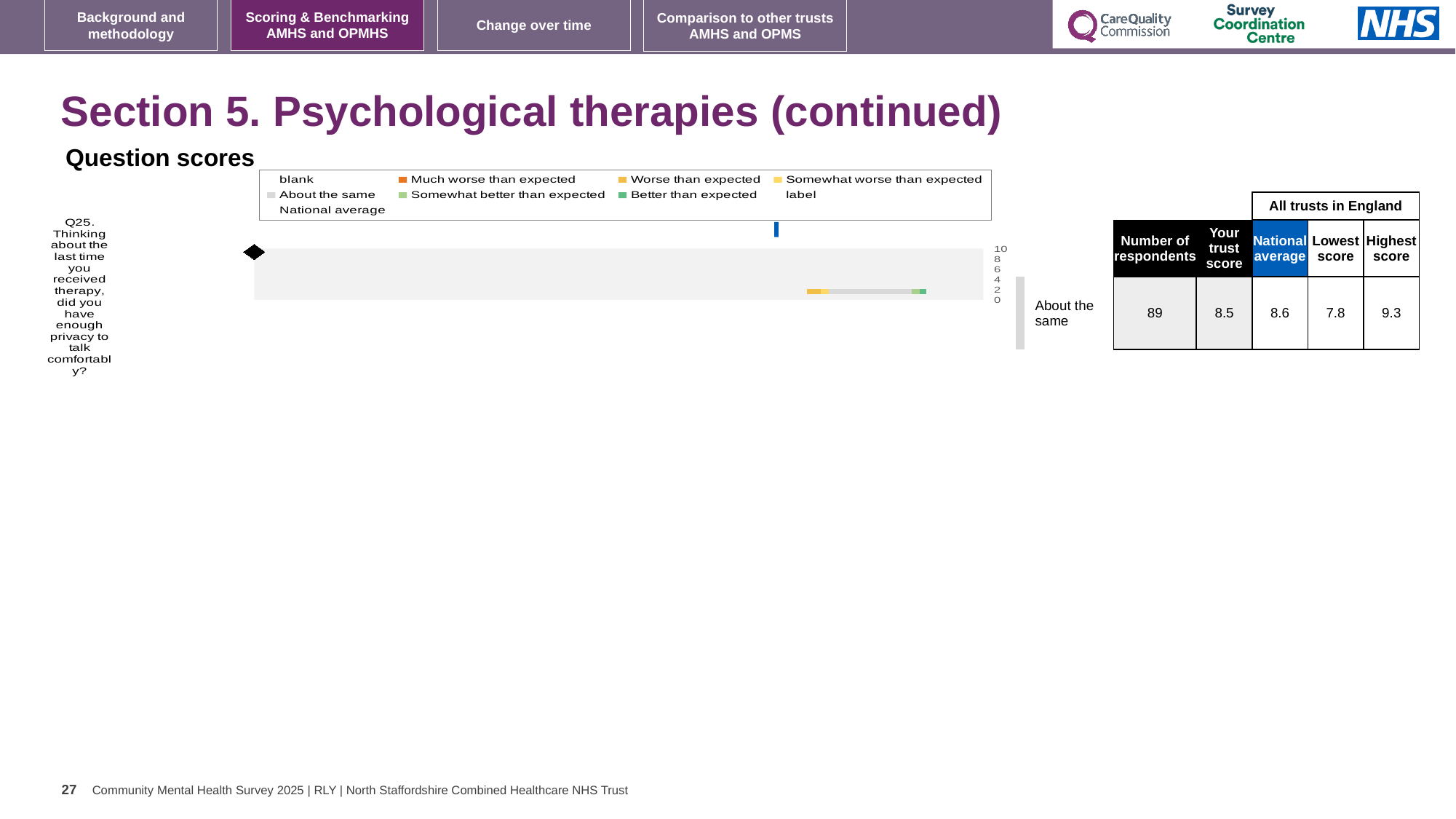
Which question number is plotted on the chart? Q25 What is the National average for Q25 in the table beside the chart? 8.6 What is the Lowest score among all trusts in England for Q25? 7.8 What is the difference between the Highest score and the Lowest score for Q25? 1.5 How many entries does the chart legend list? 9 What is the 'Your trust score' for Q25 in the table beside the chart? 8.5 For Q25, which is larger: the trust score or the National average? National average What kind of chart is shown under 'Question scores'? bar chart What is the highest value shown on the chart's score axis? 10 How many questions (categories) are plotted on the chart? 1 What is the Highest score among all trusts in England for Q25? 9.3 How many respondents are listed for Q25? 89